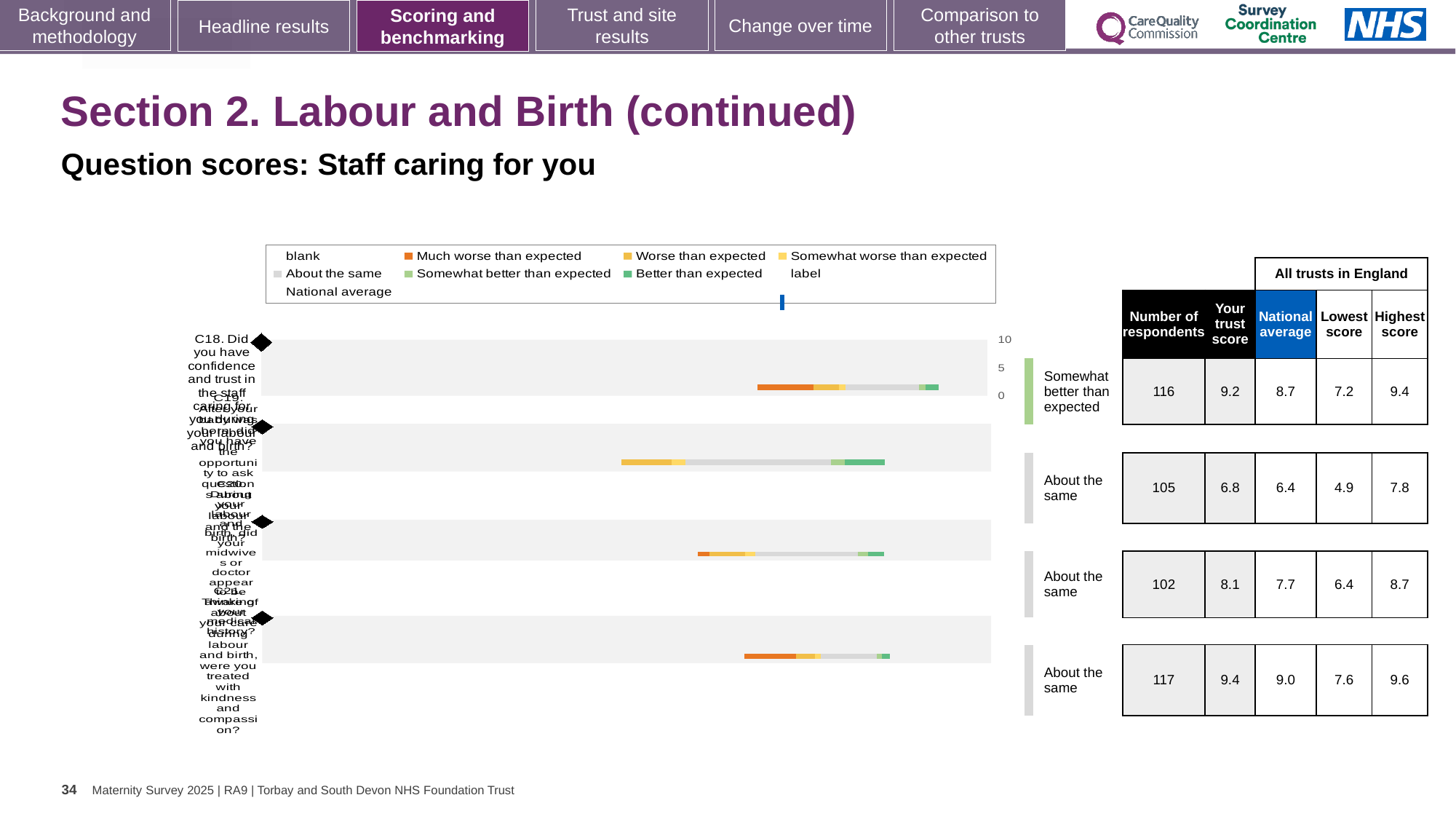
What benchmark category is shown next to the first bar (C18)? Somewhat better than expected Which legend entry is shown in grey? About the same In the table beside the chart, what is the number of respondents for the fourth row (C21)? 117 What kind of chart is shown on the slide? bar chart In the table beside the chart, is the trust score for the first row (C18) larger or smaller than the national average? larger In the table beside the chart, what is the national average for the second row (C19)? 6.4 Which legend entry is shown in orange? Much worse than expected In the table beside the chart, which row has the lowest 'Your trust score'? C19 (6.8) In the table beside the chart, what is the difference between the trust score and the national average for the third row (C20)? 0.4 How many question bars are plotted in the chart? 4 In the table beside the chart, which row has the highest 'Your trust score'? C21 (9.4) In the table beside the chart, what is the 'Your trust score' for the first row (C18)? 9.2